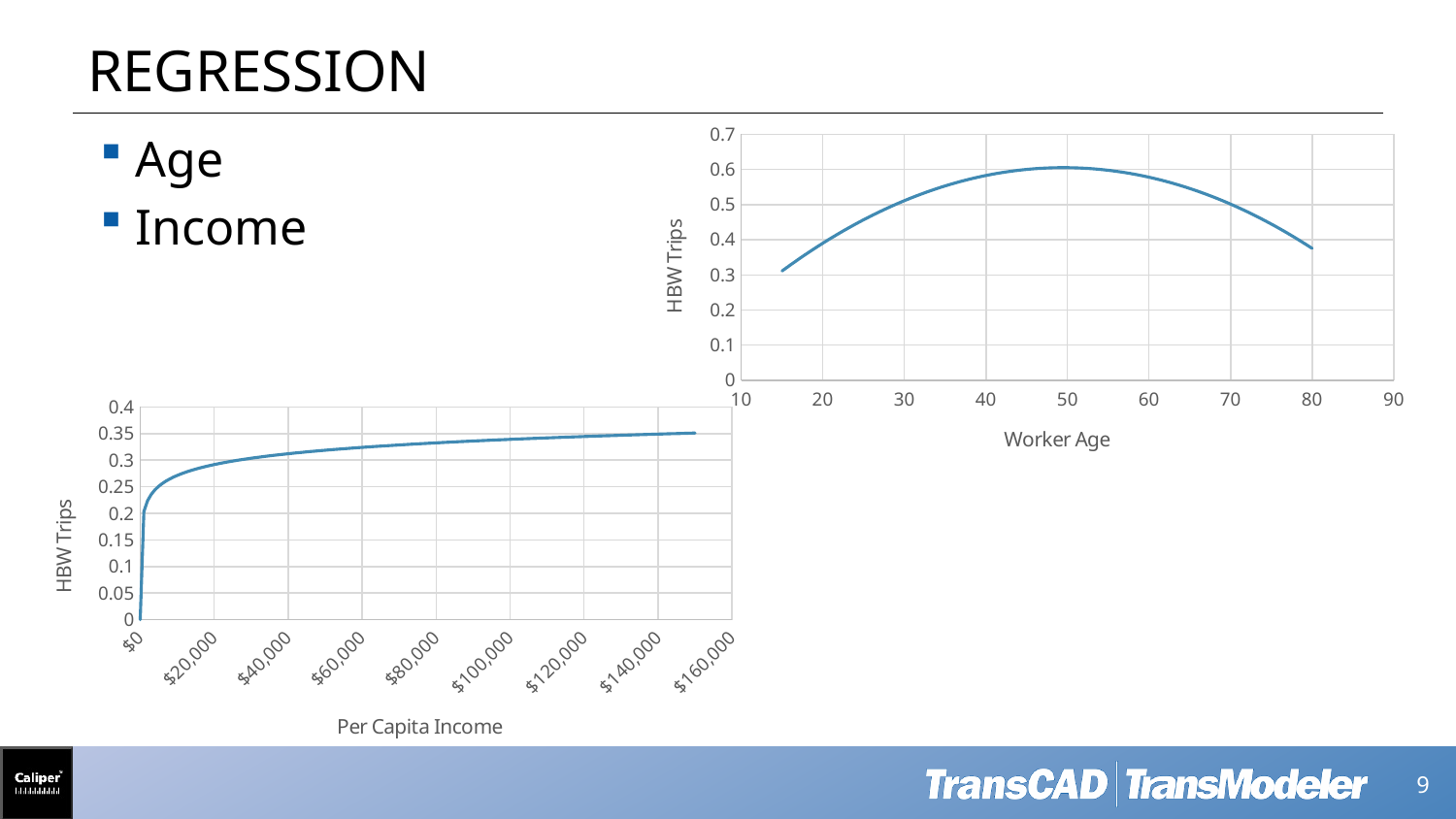
In the Worker Age chart, is the value of HBW Trips at age 50 larger or smaller than the value at age 80? larger In the Worker Age chart, is the value of HBW Trips at age 50 greater or less than 0.5? greater In the Per Capita Income chart, what is the label of the x axis? Per Capita Income In the Worker Age chart, does the HBW Trips curve rise or fall between age 20 and age 40? rise What kind of chart is the chart with the x axis labelled Worker Age? line chart In the Per Capita Income chart, do HBW Trips rise or fall as Per Capita Income increases? rise How many charts are shown on the slide? 2 In the Worker Age chart, is the value of HBW Trips at age 80 greater or less than 0.3? greater What kind of chart is the chart with the x axis labelled Per Capita Income? line chart In the Worker Age chart, does the HBW Trips curve rise or fall between age 50 and age 80? fall In the Worker Age chart, what is the label of the y axis? HBW Trips